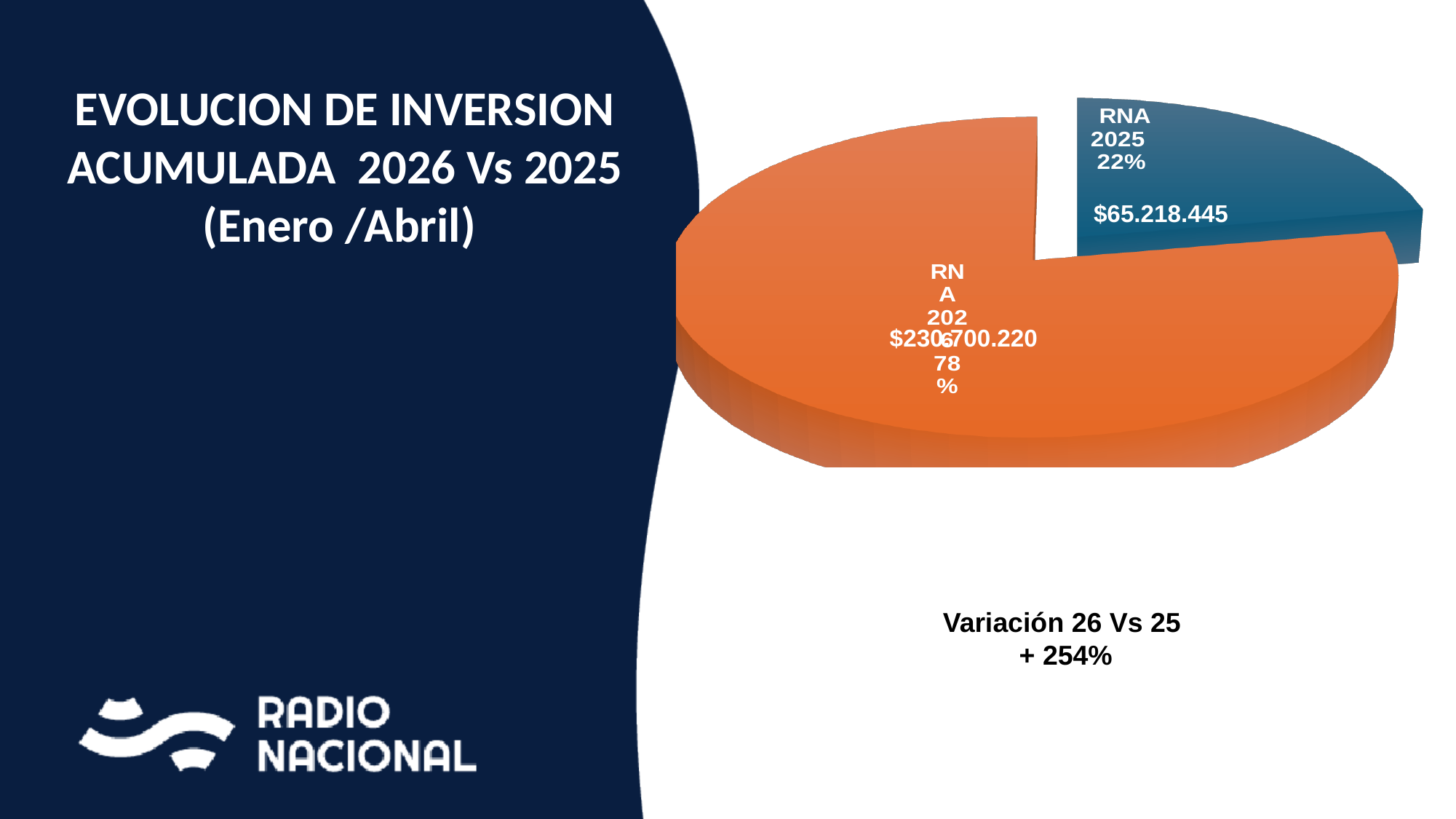
Which slice is the smallest in the pie chart? RNA 2025 What kind of chart is shown on the slide? pie chart What share of the pie does RNA 2025 represent? 22% What is the title of the slide containing the pie chart? EVOLUCION DE INVERSION ACUMULADA 2026 Vs 2025 (Enero /Abril) Which is larger, the RNA 2026 slice or the RNA 2025 slice? RNA 2026 By how many percentage points does the RNA 2026 share exceed the RNA 2025 share? 56 percentage points What is the value shown for RNA 2025? $65.218.445 What share of the pie does RNA 2026 represent? 78% Which slice is the largest in the pie chart? RNA 2026 How many slices does the pie chart have? 2 What variation between 26 and 25 is stated below the pie chart? + 254%